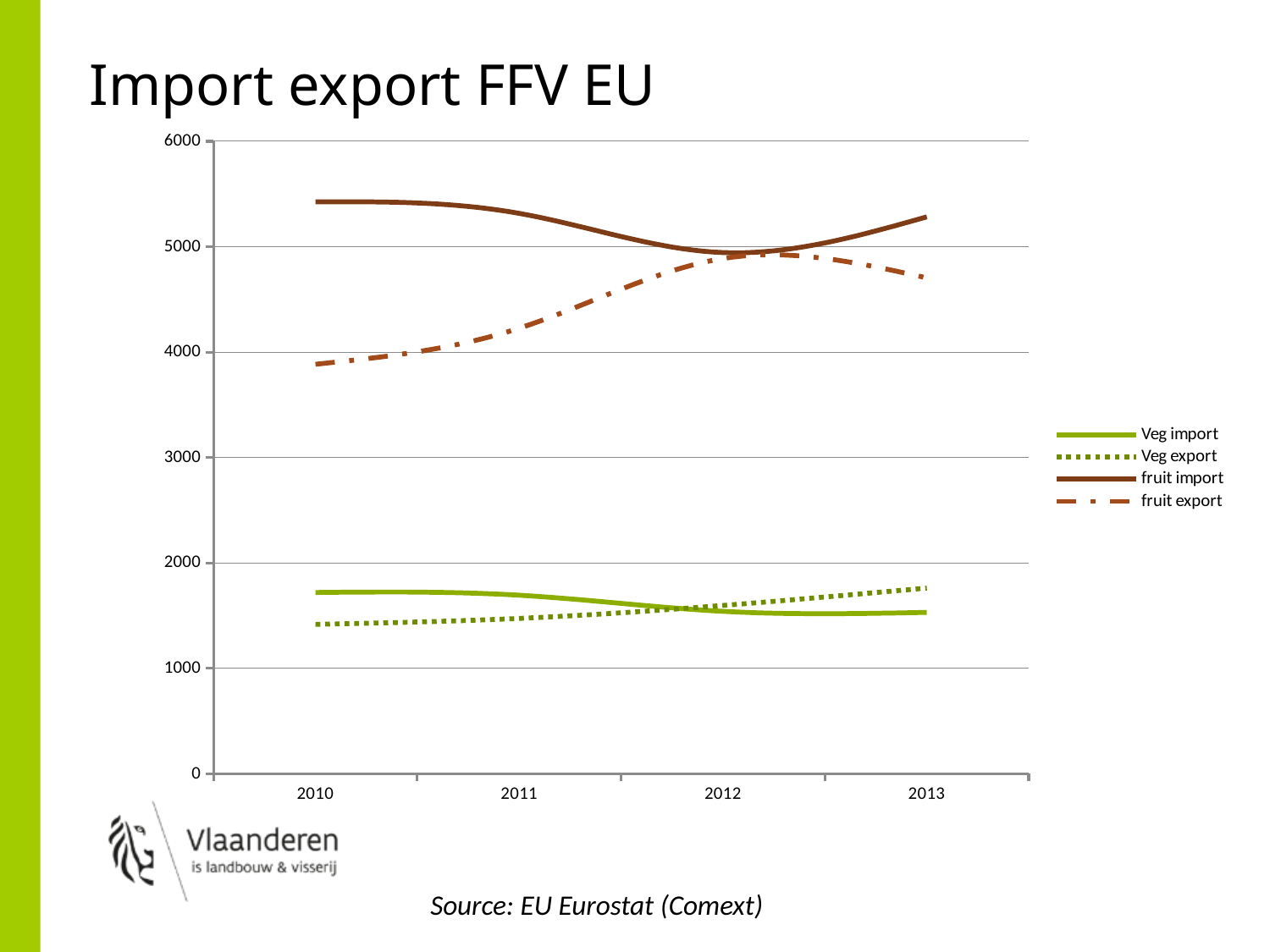
Is the value for fruit import in 2010 greater or less than 5000? greater Which series has the highest value in 2010? fruit import What is the title of the chart? Import export FFV EU How many years are shown on the x axis? 4 In 2013, which is larger: Veg import or Veg export? Veg export Is the value for Veg export in 2013 greater or less than 2000? less Which series has the lowest value in 2010? Veg export Is the value for fruit export in 2013 greater or less than 4000? greater Does the fruit export line rise or fall from 2010 to 2012? rise What kind of chart is shown on the slide? line chart How many series does the legend list? 4